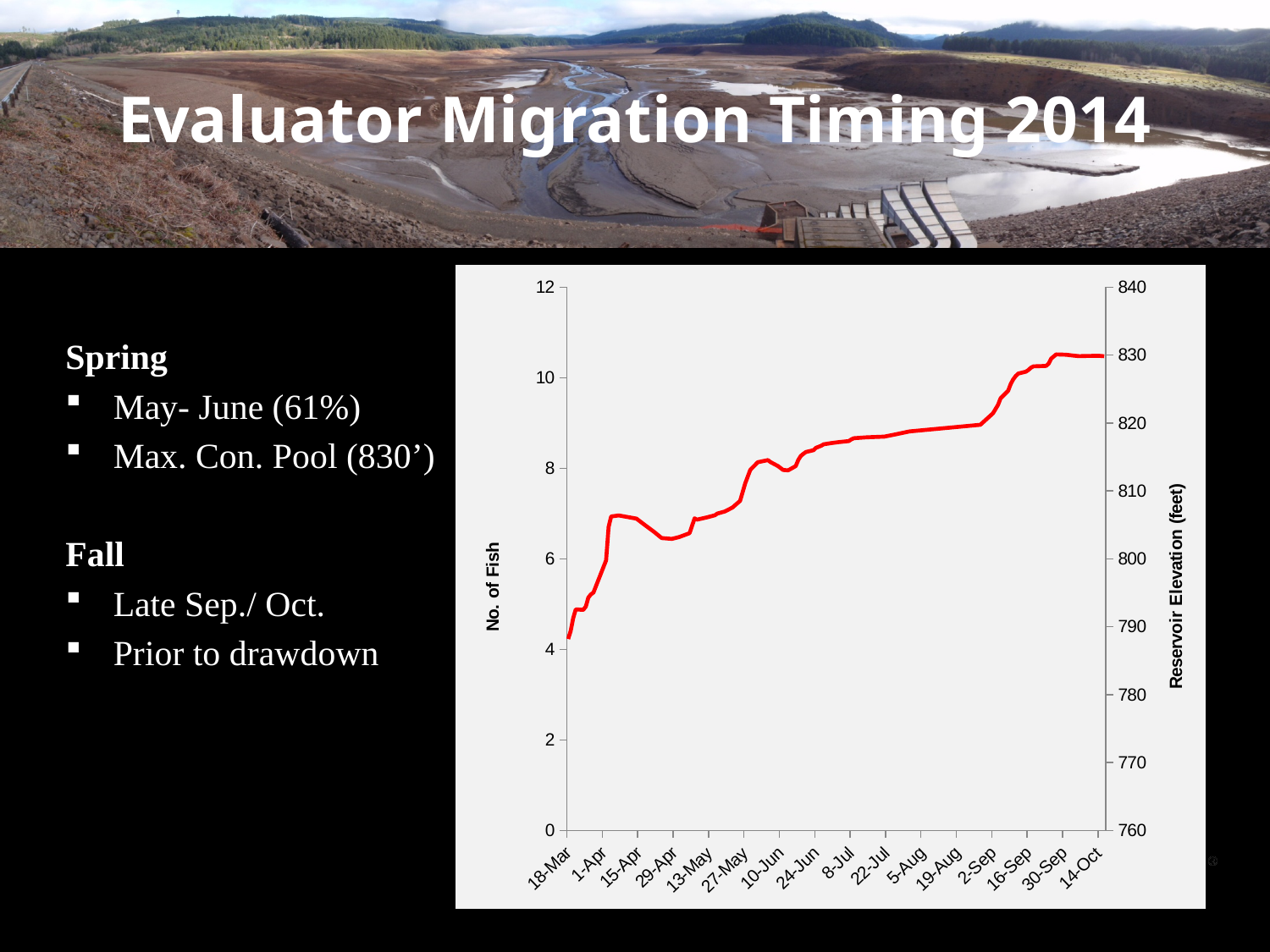
Is the red line's value at 14-Oct, read on the right-hand Reservoir Elevation axis, greater or less than 820? greater Does the red line generally rise or fall from 18-Mar to 14-Oct? rise Is the red line's value at 18-Mar, read on the right-hand Reservoir Elevation axis, greater or less than 800? less Is the red line's value at 16-Sep, read on the right-hand Reservoir Elevation axis, greater or less than 820? greater How many date labels are shown along the x axis? 16 Which is larger, the red line's value at 14-Oct or at 18-Mar? 14-Oct At which date label is the red line at its lowest point? 18-Mar What kind of chart is shown on the slide? line chart What is the title of the left-hand vertical axis? No. of Fish What is the title of the right-hand vertical axis? Reservoir Elevation (feet)